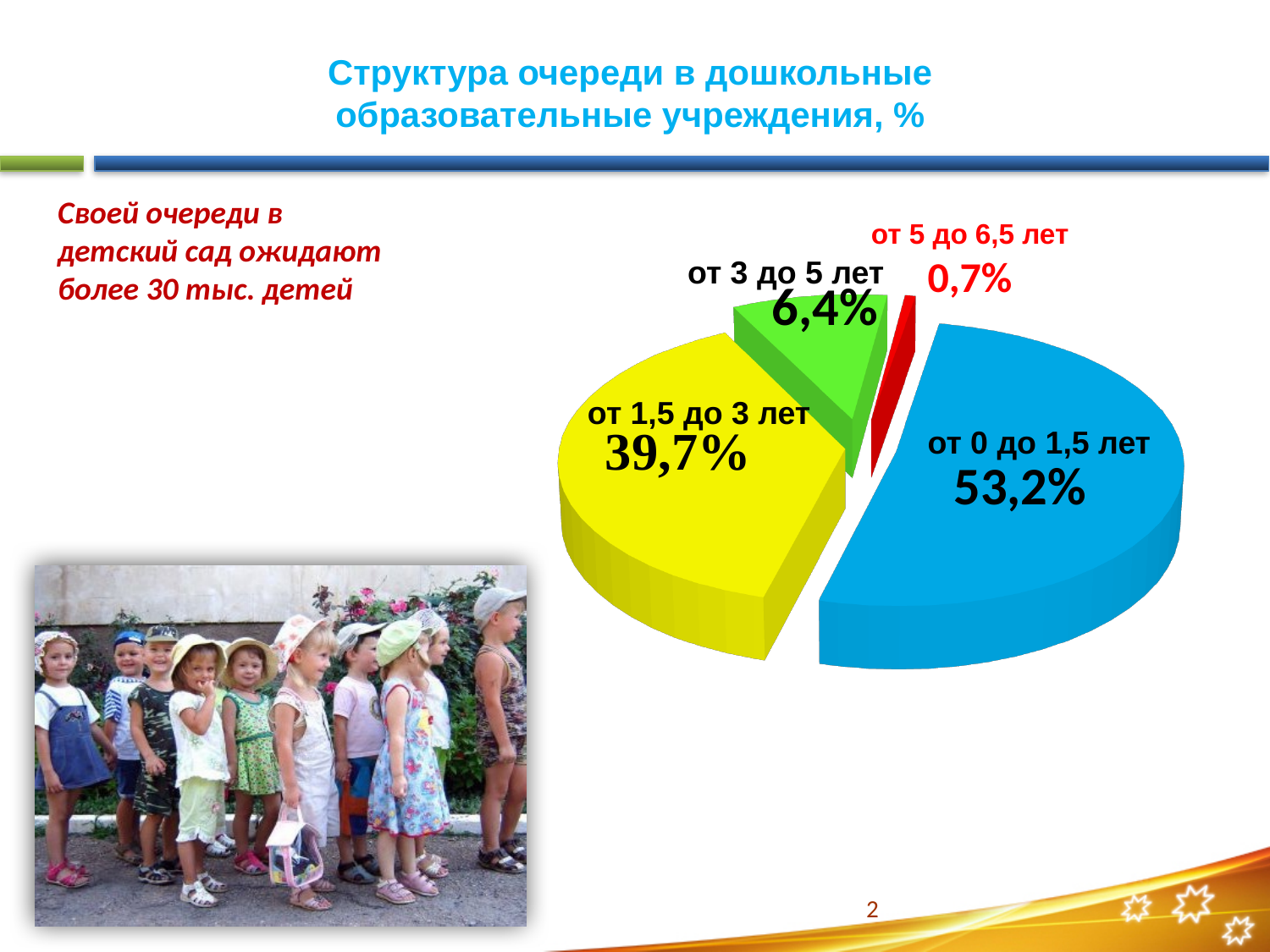
What type of chart is shown on the slide? Pie chart What share of the queue is the 'от 5 до 6,5 лет' group? 0,7% What share of the queue is the 'от 1,5 до 3 лет' group? 39,7% What colour is the slice for the 'от 1,5 до 3 лет' group? Yellow Which group has a larger share: 'от 1,5 до 3 лет' or 'от 3 до 5 лет'? от 1,5 до 3 лет What share of the queue is the 'от 0 до 1,5 лет' group? 53,2% Which age group has the smallest share of the queue? от 5 до 6,5 лет What is the difference in percentage points between the 'от 0 до 1,5 лет' and 'от 1,5 до 3 лет' groups? 13,5 What share of the queue is the 'от 3 до 5 лет' group? 6,4% Which age group has the largest share of the queue? от 0 до 1,5 лет How many age groups are shown in the pie chart? 4 What is the difference in percentage points between the 'от 3 до 5 лет' and 'от 5 до 6,5 лет' groups? 5,7